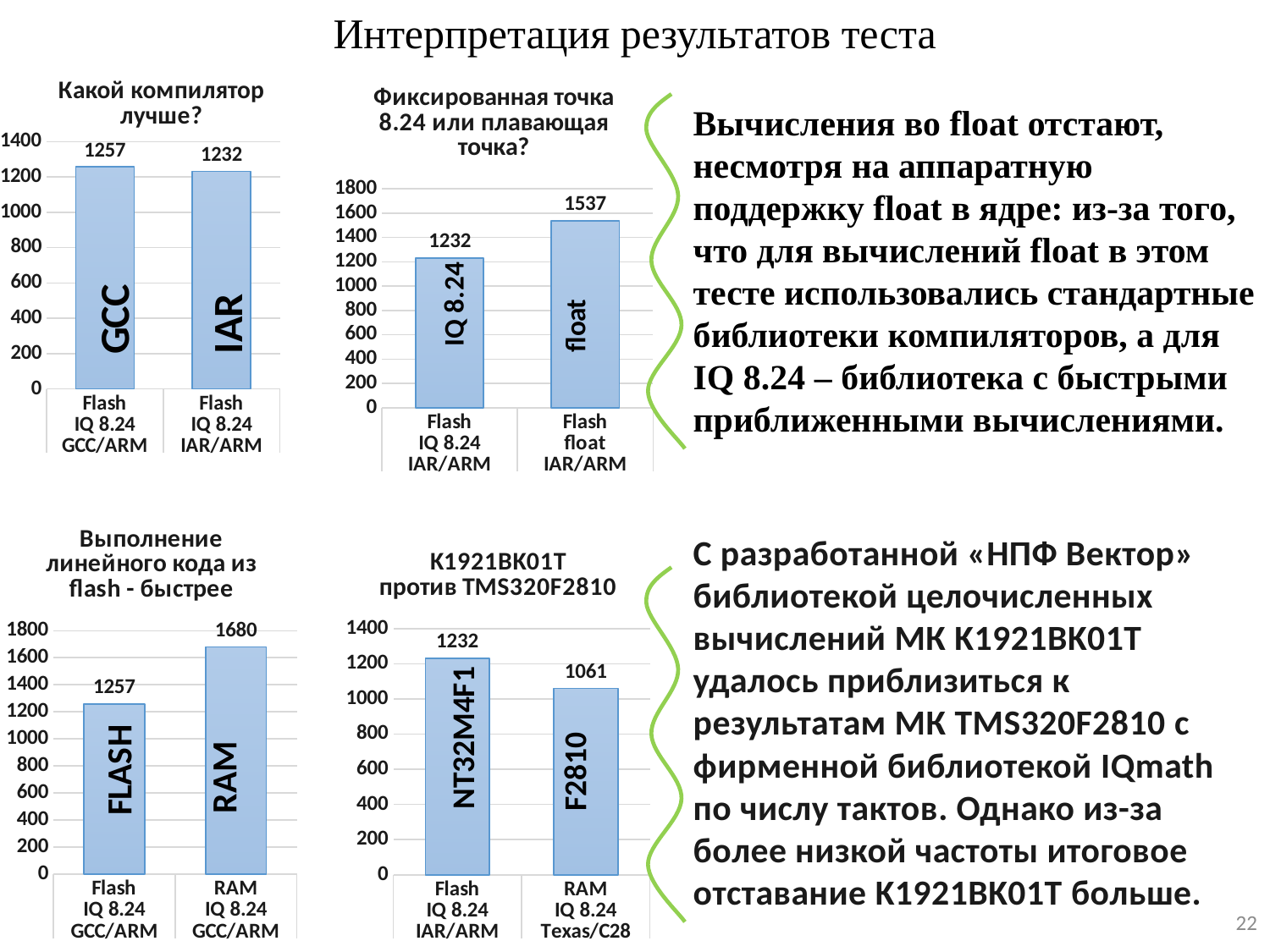
In the chart titled "К1921ВК01Т против TMS320F2810", what is the value for the F2810 bar (RAM IQ 8.24 Texas/C28)? 1061 In the chart titled "Выполнение линейного кода из flash - быстрее", which bar is the lowest? FLASH What type of chart is the chart titled "Какой компилятор лучше?"? bar chart In the chart titled "К1921ВК01Т против TMS320F2810", which bar is the highest? NT32M4F1 In the chart titled "Выполнение линейного кода из flash - быстрее", what is the difference between the RAM and FLASH values? 423 In the chart titled "Фиксированная точка 8.24 или плавающая точка?", what is the value for the float bar (Flash float IAR/ARM)? 1537 In the chart titled "Какой компилятор лучше?", what is the difference between the GCC and IAR values? 25 In the chart titled "Фиксированная точка 8.24 или плавающая точка?", what is the difference between the float and IQ 8.24 values? 305 In the chart titled "Фиксированная точка 8.24 или плавающая точка?", which bar is higher, IQ 8.24 or float? float How many bars does the chart titled "К1921ВК01Т против TMS320F2810" have? 2 In the chart titled "Выполнение линейного кода из flash - быстрее", what is the value for the RAM bar? 1680 In the chart titled "Какой компилятор лучше?", what is the value for the GCC bar (Flash IQ 8.24 GCC/ARM)? 1257